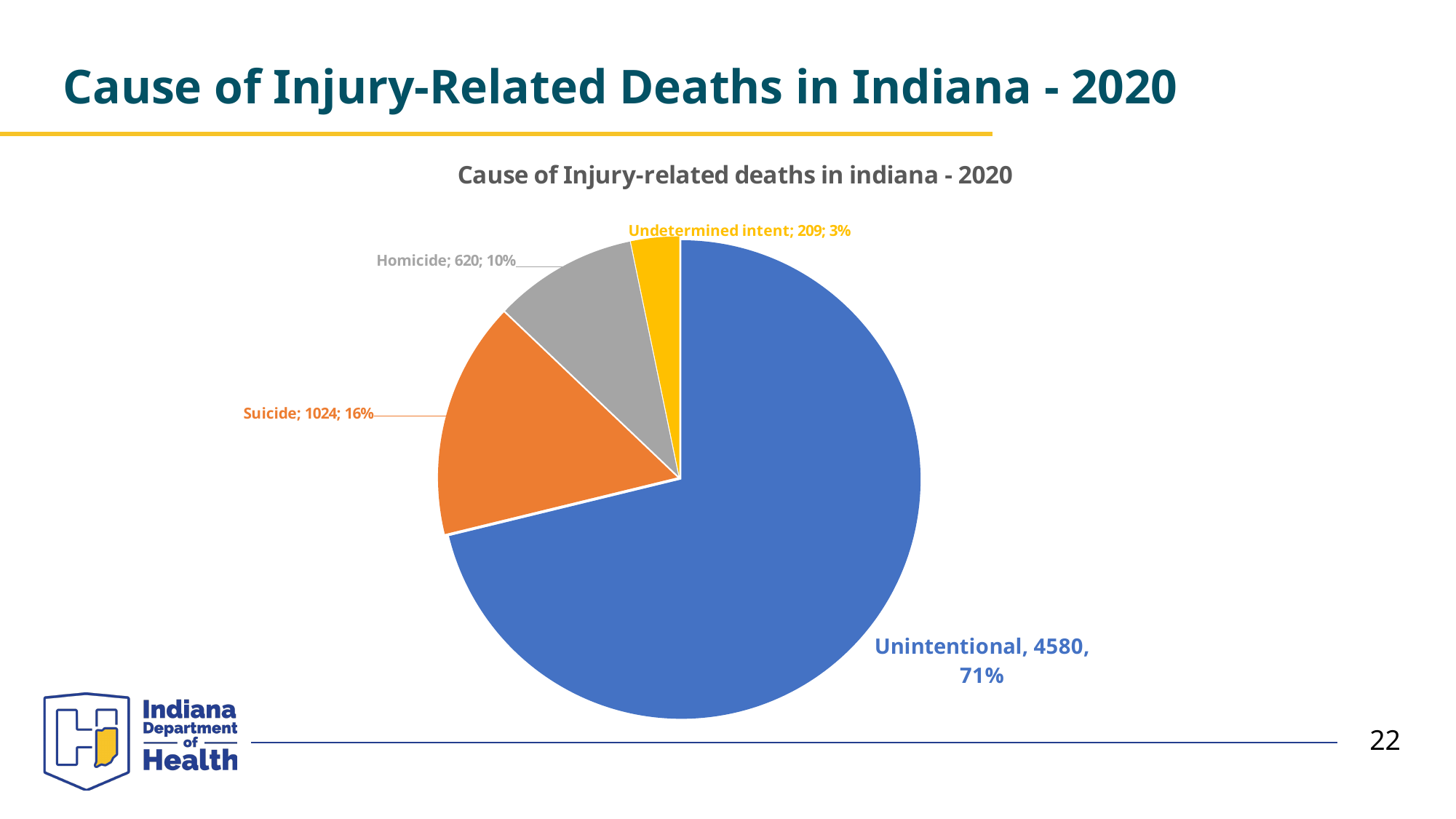
What type of chart is shown on the slide? pie chart How many deaths are attributed to Suicide? 1024 How many deaths are attributed to Homicide? 620 What share of the pie does Suicide represent? 16% Which cause accounts for the largest number of deaths? Unintentional Which has more deaths, Homicide or Undetermined intent? Homicide How many deaths are attributed to Unintentional causes? 4580 What percentage of injury-related deaths are of Undetermined intent? 3% What is the title of the chart? Cause of Injury-related deaths in indiana - 2020 What is the difference in deaths between Suicide and Homicide? 404 How many categories are shown in the pie chart? 4 Which cause accounts for the smallest number of deaths? Undetermined intent